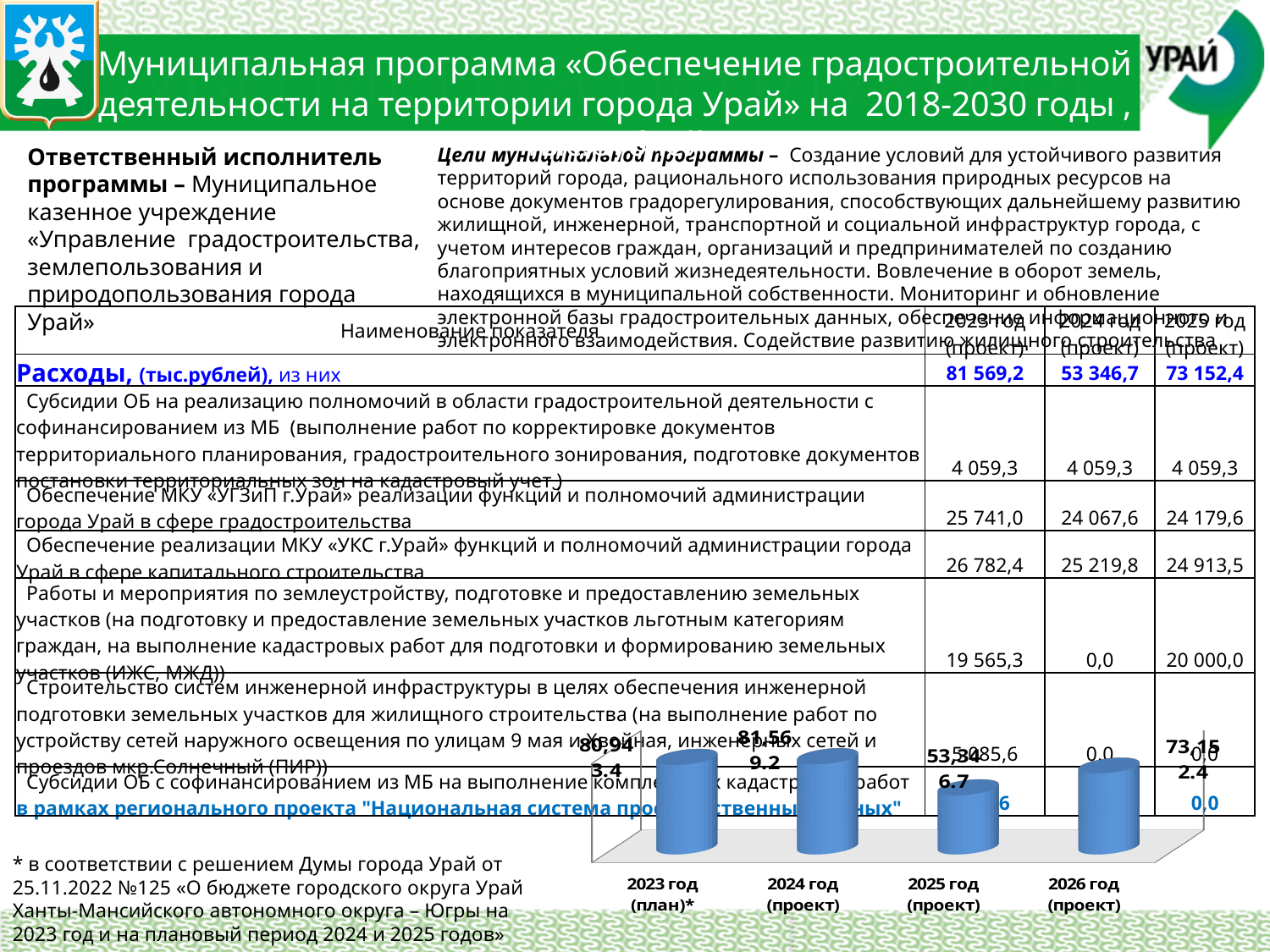
How many year categories are shown on the x axis of the bar chart? 4 Do the labelled bar values rise or fall from 2024 год (проект) to 2025 год (проект)? fall Which bar is taller, 2025 год (проект) or 2026 год (проект)? 2026 год (проект) Which year has the highest labelled bar value in the chart? 2024 год (проект) What is the difference between the labelled values for 2026 год (проект) and 2025 год (проект)? 19,805.7 What is the value labelled on the bar for 2023 год (план)*? 80,943.4 What is the value labelled on the bar for 2024 год (проект)? 81,569.2 What kind of chart is shown at the bottom of the slide? bar chart What is the value labelled on the bar for 2026 год (проект)? 73,152.4 What is the difference between the labelled values for 2023 год (план)* and 2025 год (проект)? 27,596.7 What is the value labelled on the bar for 2025 год (проект)? 53,346.7 Which year has the lowest labelled bar value in the chart? 2025 год (проект)